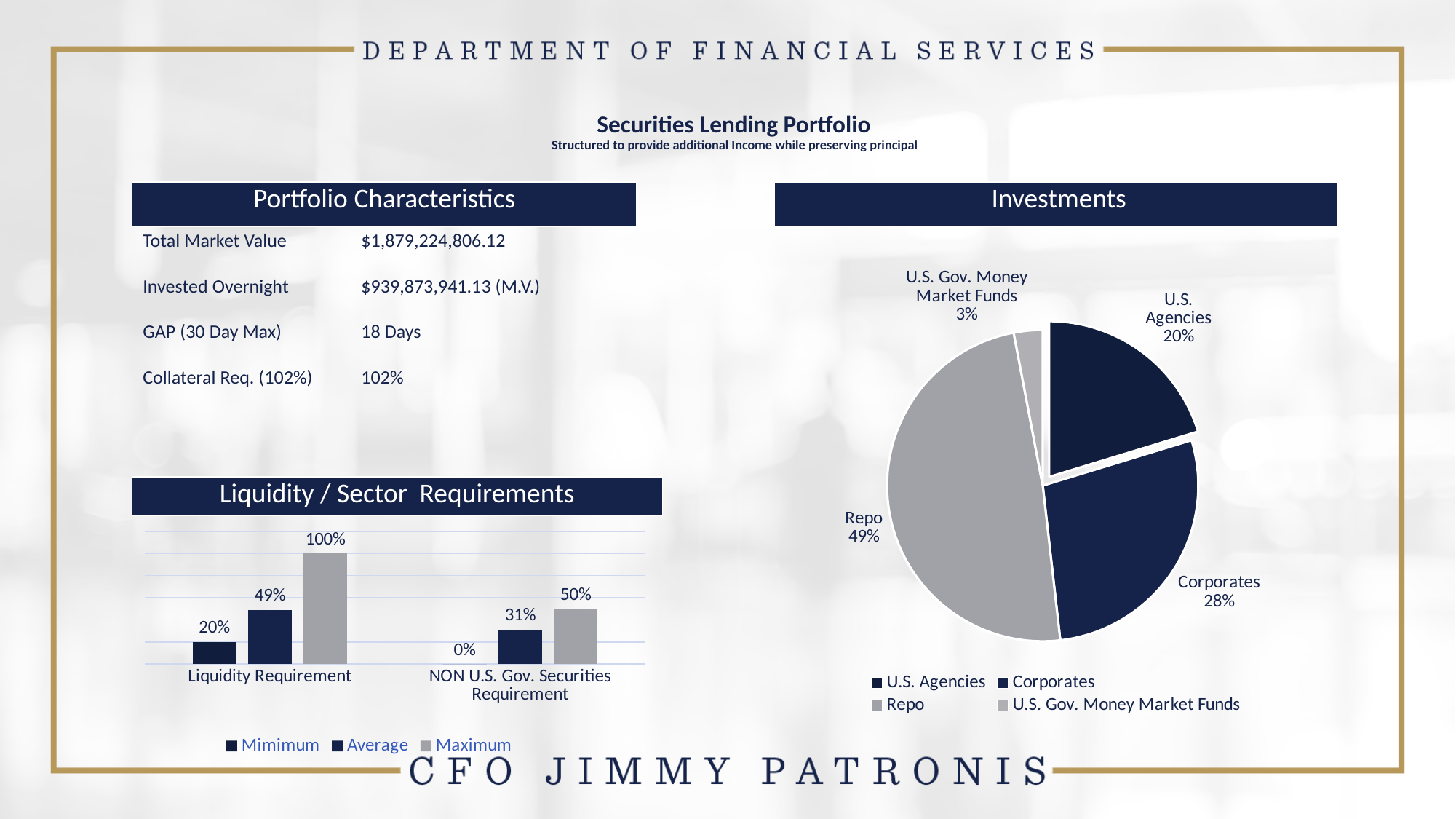
In the Liquidity / Sector Requirements chart, what is the Maximum value for Liquidity Requirement? 100% In the Investments pie chart, what share do Corporates have? 28% In the Investments pie chart, what is the difference between the Repo share and the U.S. Agencies share? 29% In the Investments pie chart, how many categories are shown? 4 In the Investments pie chart, which category has the largest share? Repo In the Investments pie chart, which category has the smallest share? U.S. Gov. Money Market Funds What kind of chart is the Liquidity / Sector Requirements chart? Bar chart In the Investments pie chart, what share does Repo have? 49% In the Liquidity / Sector Requirements chart, which is larger: the Average for Liquidity Requirement or the Average for NON U.S. Gov. Securities Requirement? Average for Liquidity Requirement In the Liquidity / Sector Requirements chart, how many series does the legend list? 3 In the Liquidity / Sector Requirements chart, what is the Average value for NON U.S. Gov. Securities Requirement? 31% In the Liquidity / Sector Requirements chart, what is the Minimum value for NON U.S. Gov. Securities Requirement? 0%